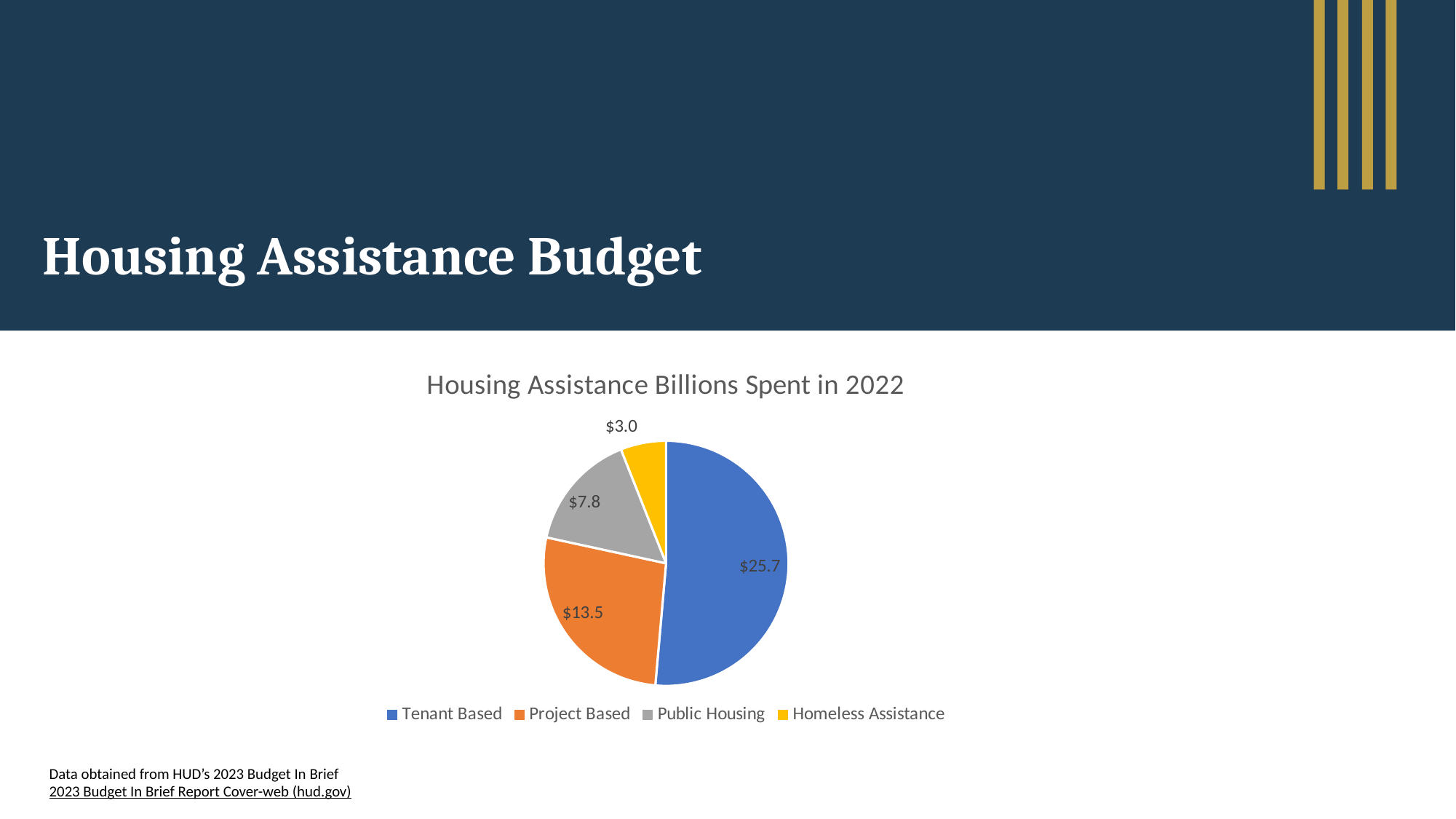
What is the title of the chart? Housing Assistance Billions Spent in 2022 Which category has the smallest slice of the pie? Homeless Assistance How many categories does the legend list? 4 What type of chart is shown on the slide? Pie chart What is the difference between the Tenant Based and Project Based values? $12.2 Which category has the largest slice of the pie? Tenant Based What is the value for Tenant Based? $25.7 What is the value for Project Based? $13.5 What share of the total does the Homeless Assistance slice represent? 6% What is the value for Public Housing? $7.8 Which is larger, Public Housing or Homeless Assistance? Public Housing What is the value for Homeless Assistance? $3.0